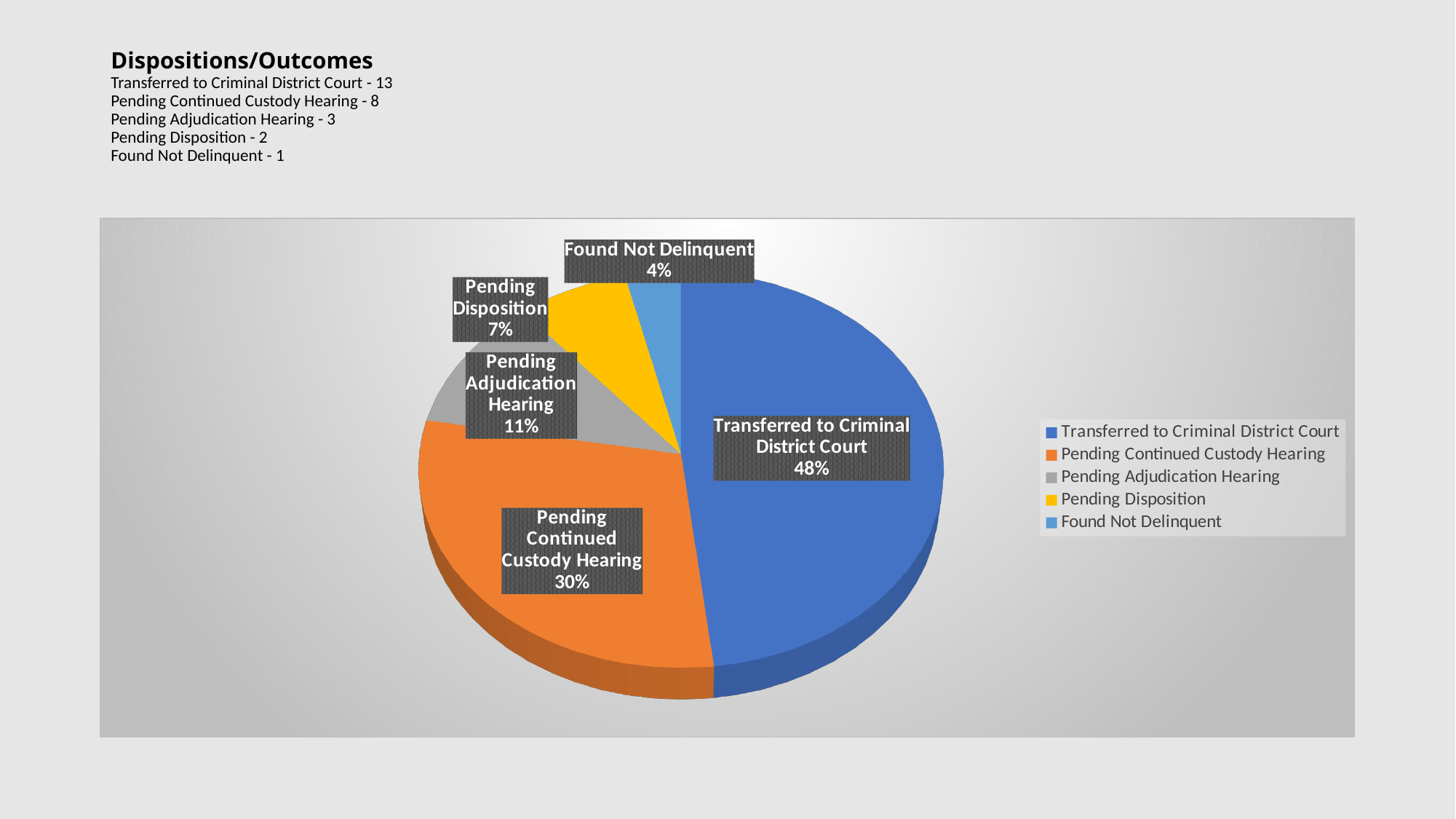
Which is larger, the share for Pending Adjudication Hearing or the share for Pending Disposition? Pending Adjudication Hearing What is the difference in percentage points between Transferred to Criminal District Court and Pending Continued Custody Hearing? 18 How many slices does the pie chart have? 5 What share of the pie does Pending Continued Custody Hearing represent? 30% Which category has the largest slice of the pie? Transferred to Criminal District Court What kind of chart is shown on the slide? pie chart What colour is the Pending Disposition slice? yellow Which category has the smallest slice of the pie? Found Not Delinquent What share of the pie does Pending Adjudication Hearing represent? 11% What share of the pie does Found Not Delinquent represent? 4%